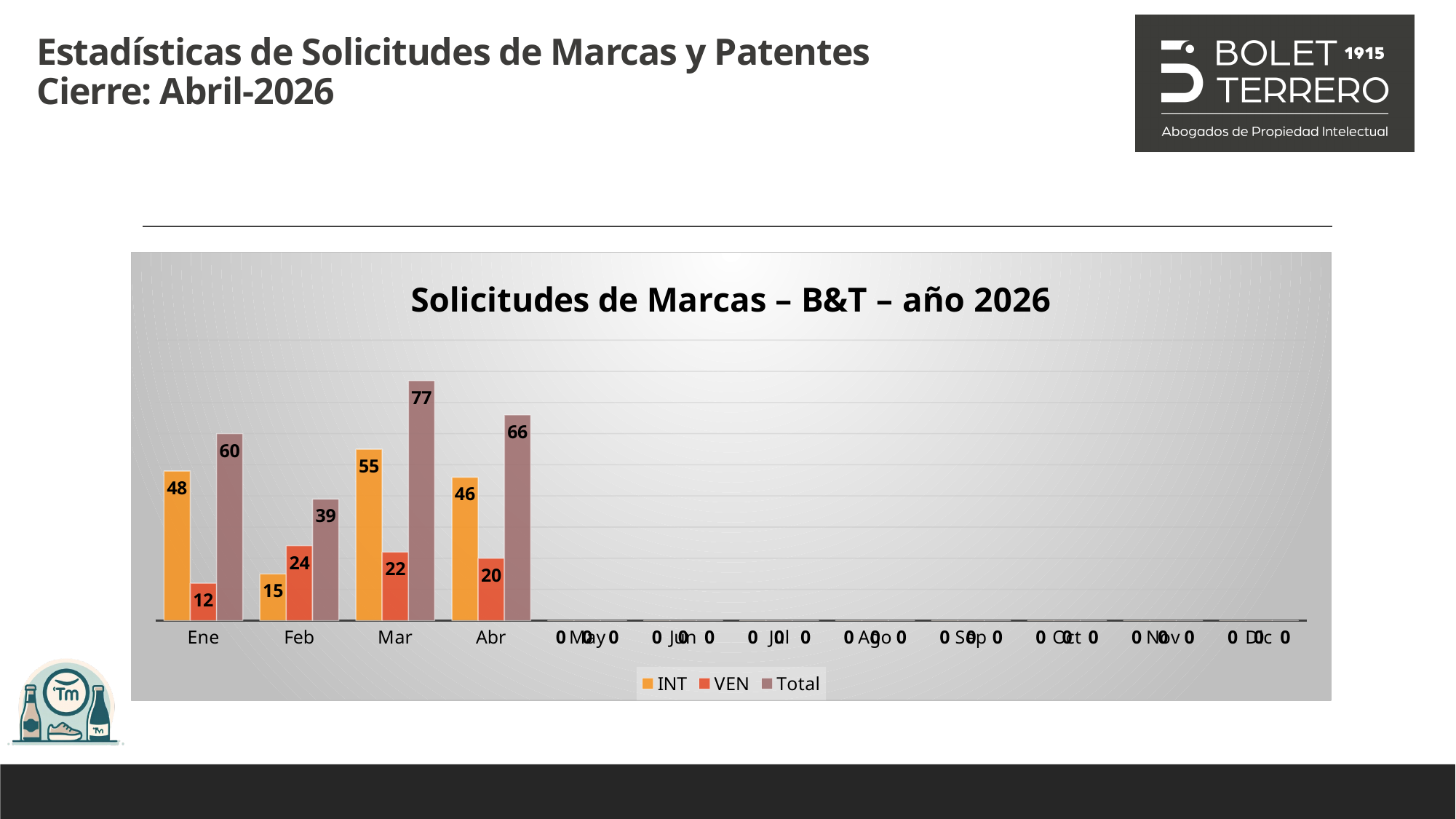
What is the INT value for Mar? 55 How many series does the legend list? 3 What is the title of the chart? Solicitudes de Marcas – B&T – año 2026 How many months are shown on the x axis? 12 What is the difference between the INT and VEN values for Ene? 36 What is the Total value for Abr? 66 Which is larger, the VEN value for Ene or the VEN value for Abr? Abr What kind of chart is shown? Bar chart Which month has the highest Total value? Mar What is the VEN value for Feb? 24 What is the difference between the Total values for Mar and Feb? 38 Among the months with non-zero values, which month has the lowest INT value? Feb